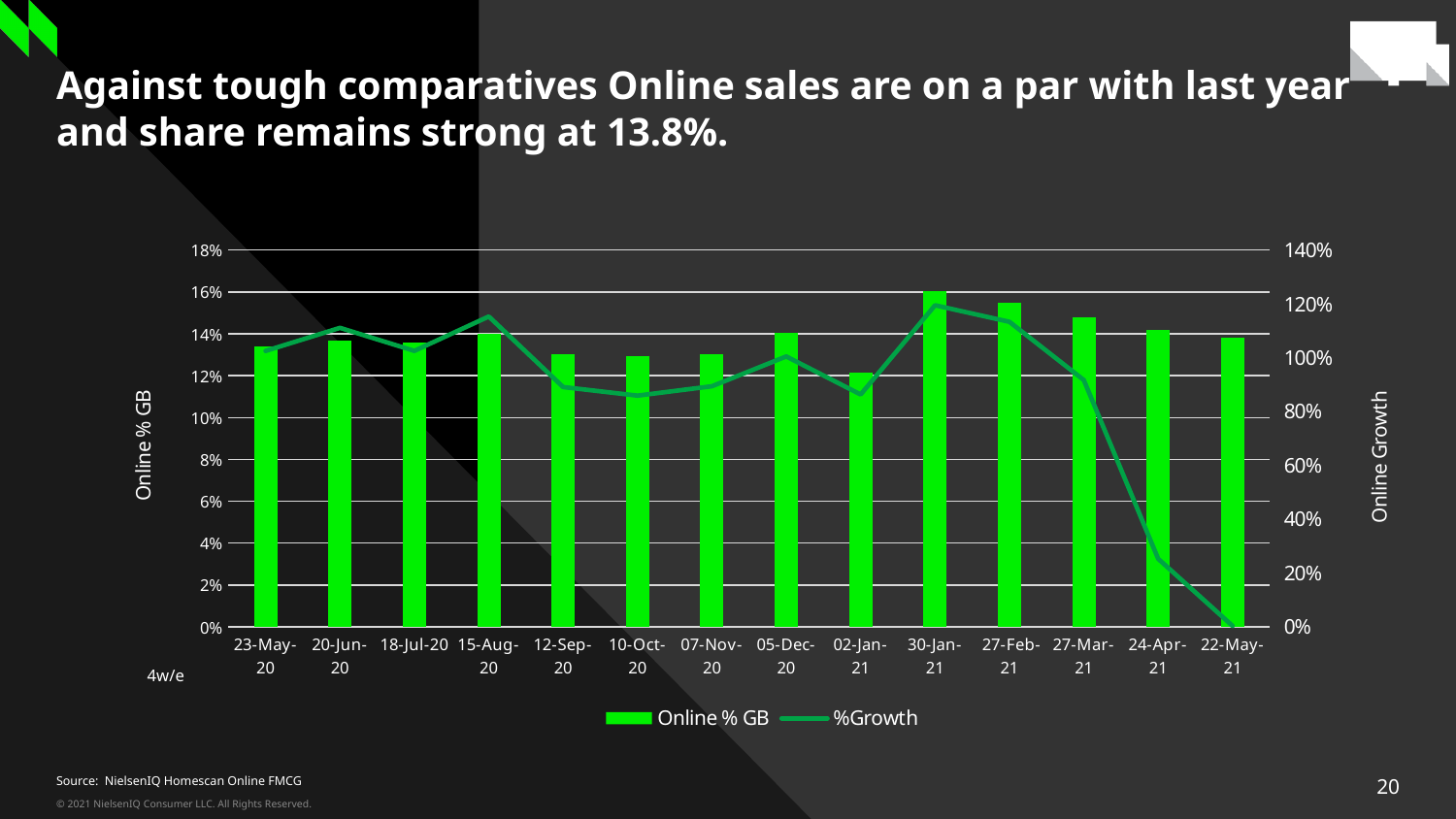
Which period has the highest Online % GB bar? 30-Jan-21 Is the Online % GB value for 02-Jan-21 greater or less than 14%? less How many 4w/e periods are plotted along the x axis? 14 Is the Online % GB value for 30-Jan-21 greater or less than 14%? greater What kind of chart is shown on the slide? A combined bar and line chart Which is larger, the %Growth value for 15-Aug-20 or for 12-Sep-20? 15-Aug-20 How many series does the legend list? 2 In which period is the %Growth line at its lowest? 22-May-21 Is the %Growth value for 22-May-21 greater or less than 20%? less Does the %Growth line rise or fall from 27-Feb-21 to 22-May-21? Fall Which period has the lowest Online % GB bar? 02-Jan-21